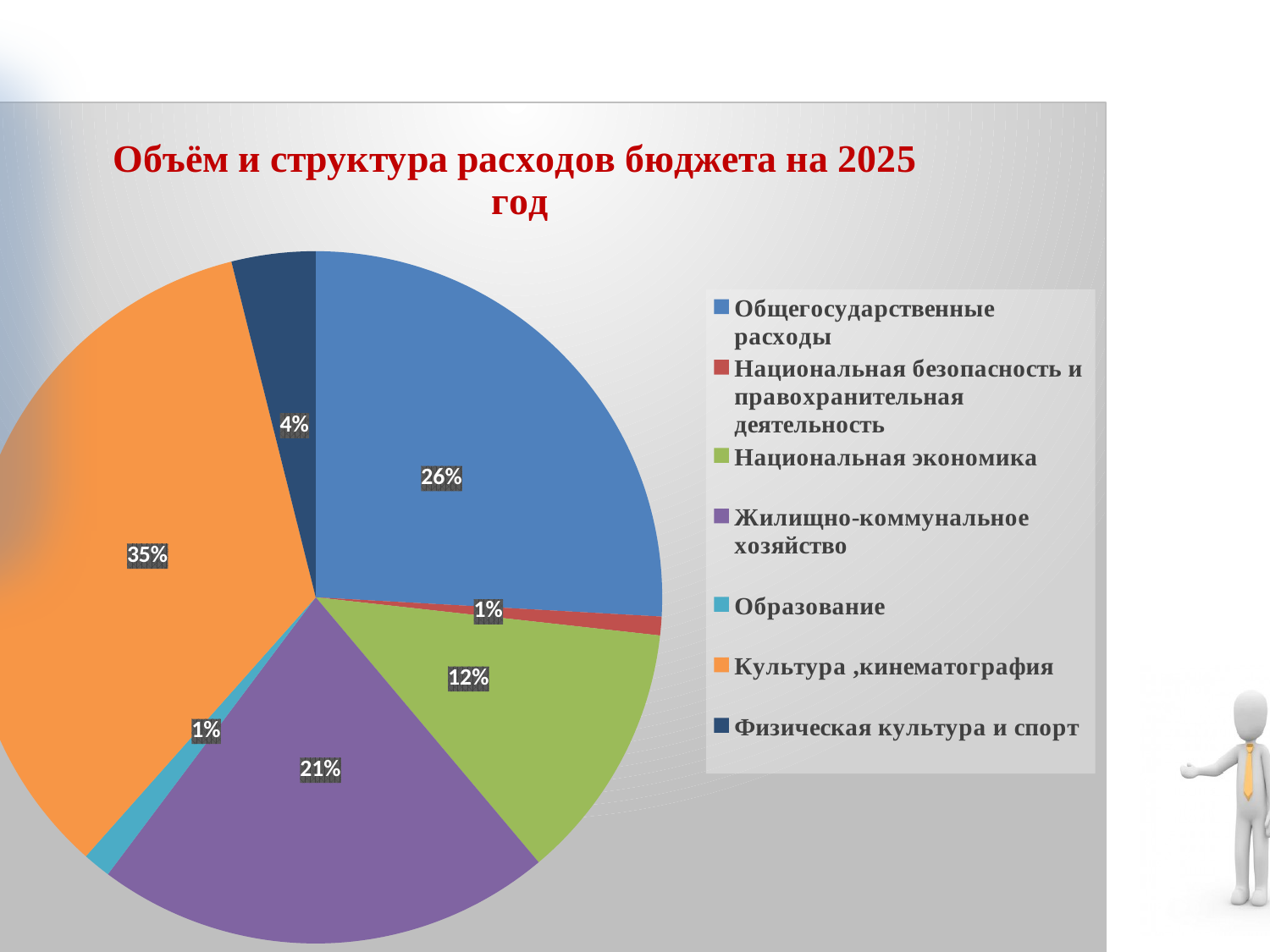
What share of the pie is Национальная экономика? 12% How many categories does the legend list? 7 Which category has the largest share of the pie? Культура, кинематография Which is larger: the share for Общегосударственные расходы or the share for Жилищно-коммунальное хозяйство? Общегосударственные расходы What is the title of the chart? Объём и структура расходов бюджета на 2025 год What share of the pie is Физическая культура и спорт? 4% What kind of chart is shown on the slide? Pie chart What is the difference in percentage points between the share for Культура, кинематография and the share for Национальная экономика? 23 What share of the pie is Жилищно-коммунальное хозяйство? 21% Which colour represents Физическая культура и спорт in the chart? Dark blue